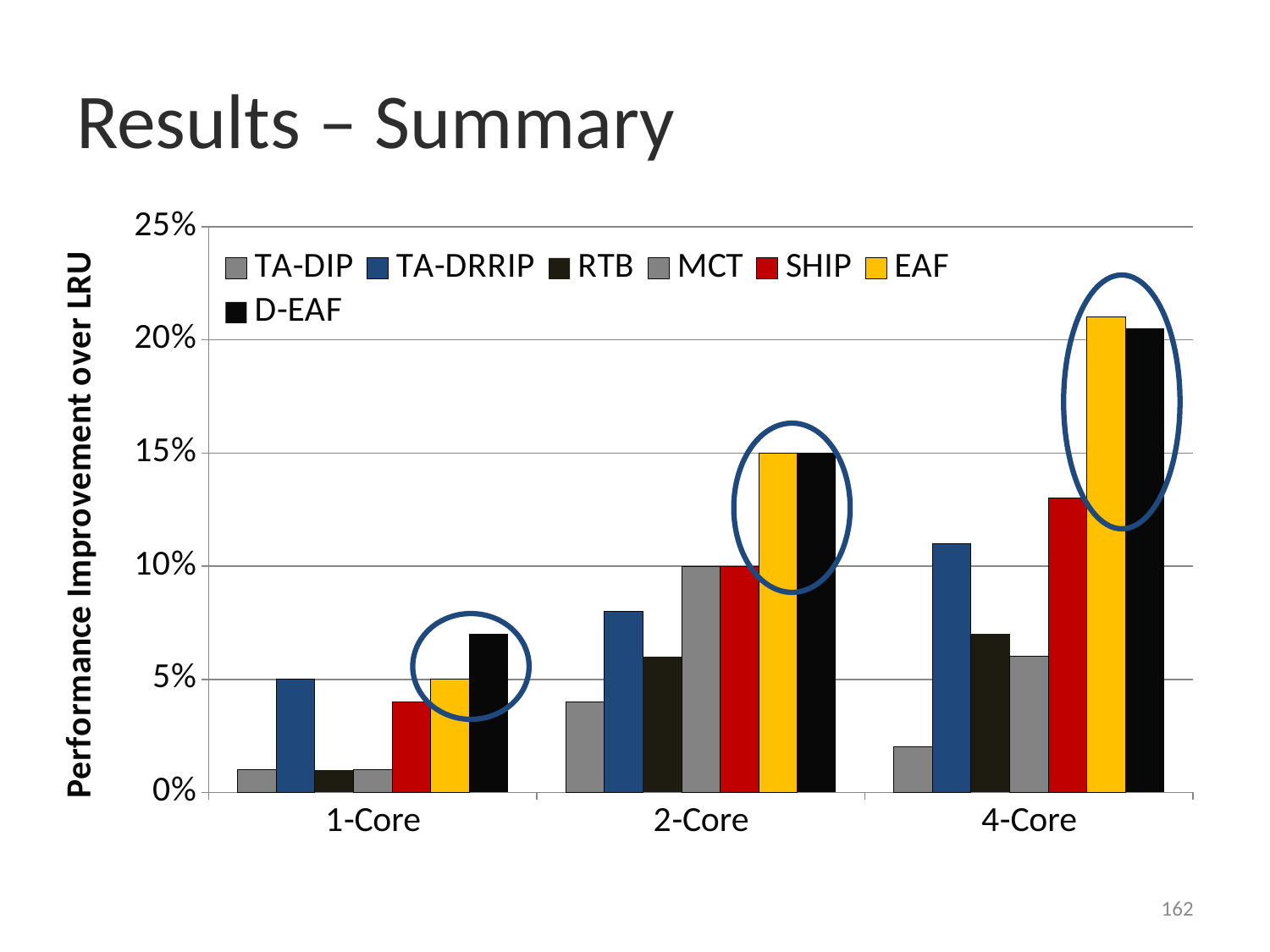
Is the value for EAF in the 4-Core category greater or less than 20%? greater How many series does the legend list? 7 Which series has the lowest value in the 4-Core category? TA-DIP What is the value for MCT in the 2-Core category? 10% Is the value for SHIP in the 4-Core category greater or less than 15%? less Is the value for TA-DIP in the 2-Core category greater or less than 5%? less How many categories are shown on the x axis? 3 What is the value for TA-DRRIP in the 1-Core category? 5% What is the value for EAF in the 2-Core category? 15% What kind of chart is shown on the slide? bar chart What is the y-axis label of the chart? Performance Improvement over LRU Does the value for EAF rise or fall from 1-Core to 4-Core? rise